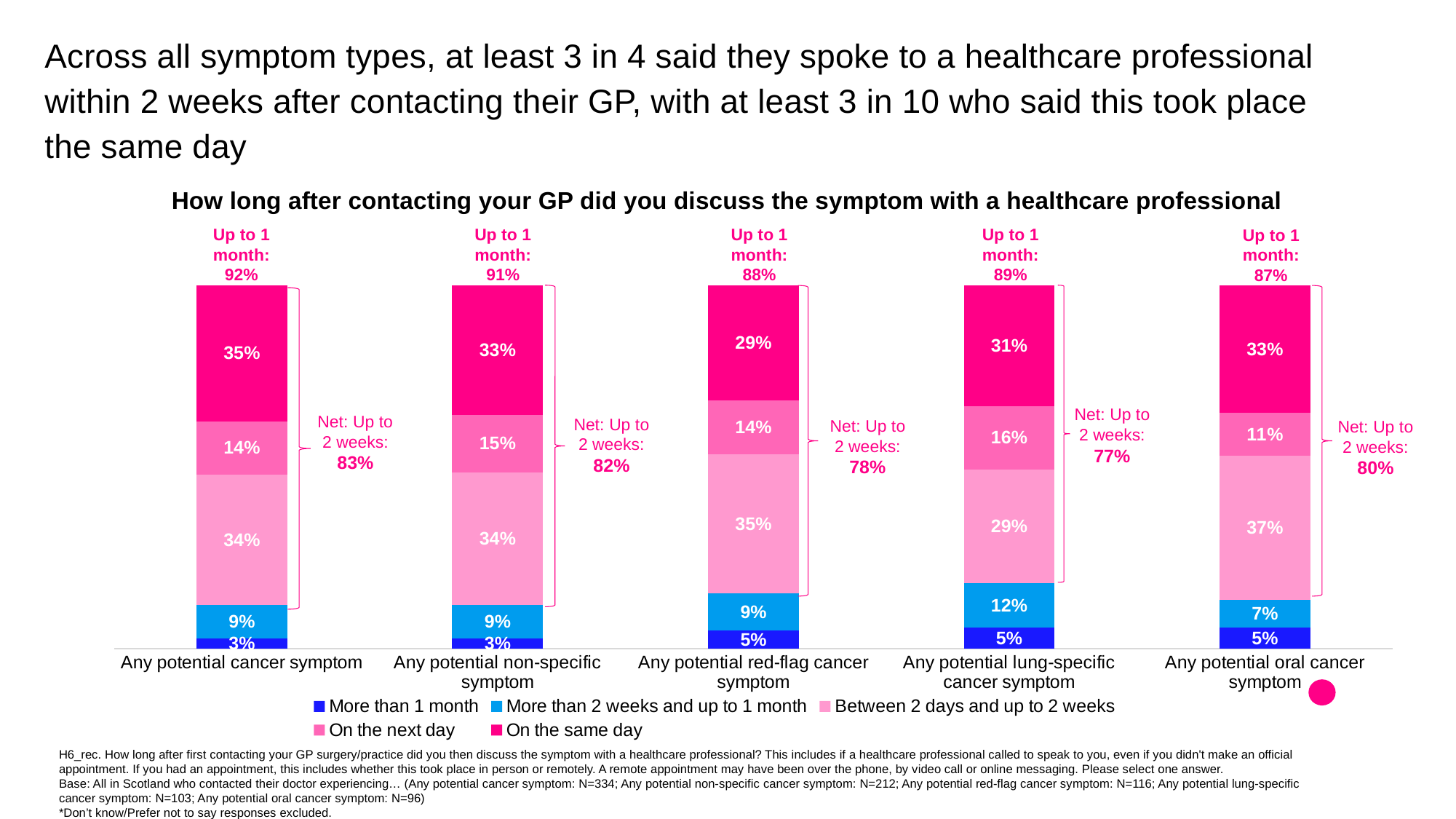
Which has a larger 'More than 2 weeks and up to 1 month' value: any potential lung-specific cancer symptom or any potential oral cancer symptom? Any potential lung-specific cancer symptom What is the value for 'Between 2 days and up to 2 weeks' for any potential oral cancer symptom? 37% Which symptom category has the highest 'On the same day' percentage? Any potential cancer symptom Which symptom category has the lowest 'Net: Up to 2 weeks' figure? Any potential lung-specific cancer symptom What kind of chart is shown on the slide? Stacked bar chart How many symptom categories are shown on the x axis? 5 What percentage of respondents with any potential red-flag cancer symptom discussed the symptom on the same day? 29% How many series does the legend list? 5 What is the 'Net: Up to 2 weeks' figure for any potential oral cancer symptom? 80% What is the difference in the 'On the same day' percentage between any potential cancer symptom and any potential red-flag cancer symptom? 6 percentage points What is the title of the chart? How long after contacting your GP did you discuss the symptom with a healthcare professional What is the 'Up to 1 month' figure shown above the bar for any potential non-specific symptom? 91%